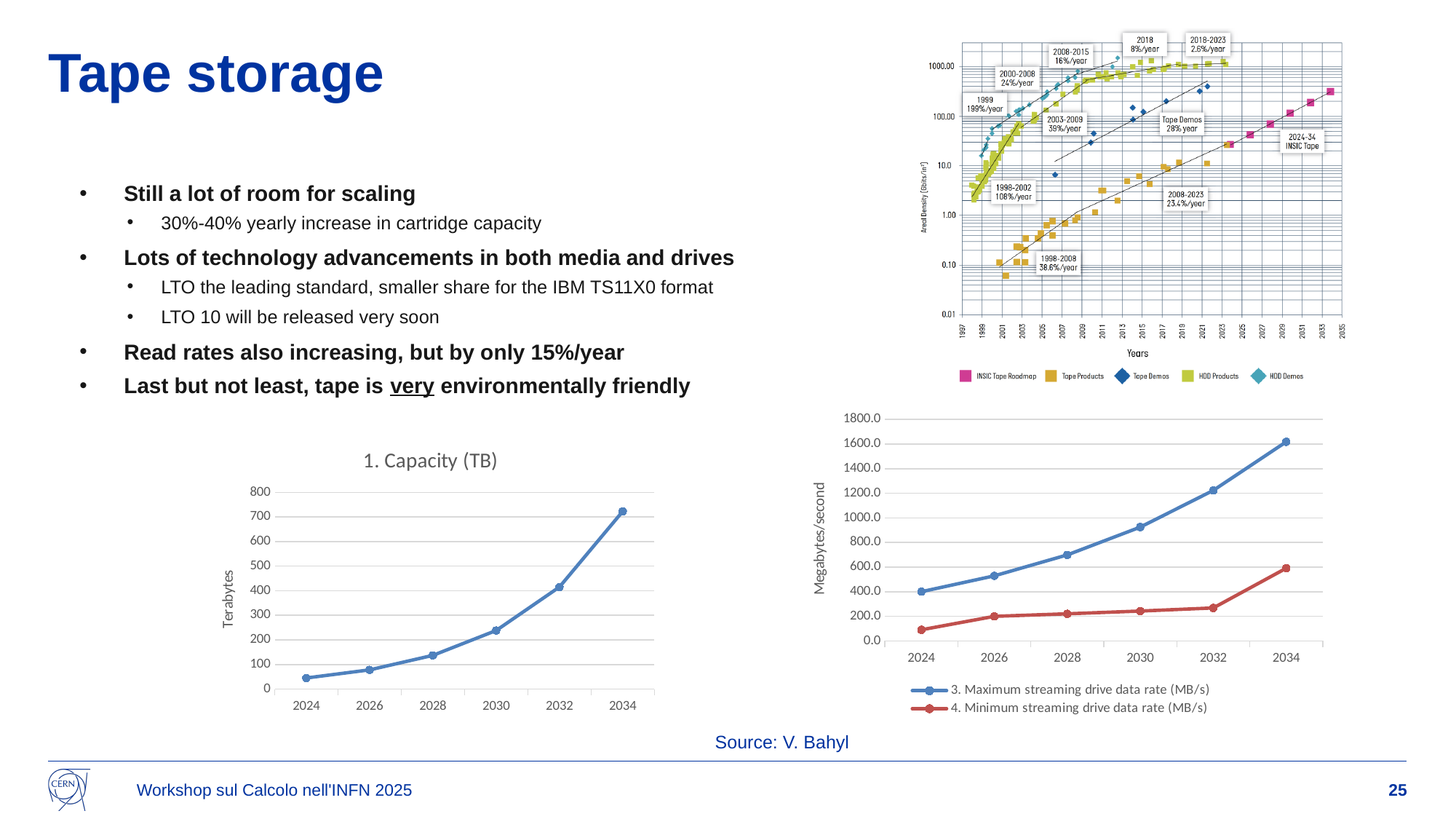
In the '1. Capacity (TB)' chart, which year has the highest capacity? 2034 In the '1. Capacity (TB)' chart, is the value for 2030 greater or less than 200? greater In the '1. Capacity (TB)' chart, do the values rise or fall from 2024 to 2034? rise In the streaming drive data rate chart at the bottom right, how many series does the legend list? 2 In the streaming drive data rate chart at the bottom right, is the value of '4. Minimum streaming drive data rate (MB/s)' for 2024 greater or less than 200.0? less In the '1. Capacity (TB)' chart, is the value for 2024 greater or less than 100? less In the areal density chart at the top right, how many series does the legend list? 5 What kind of chart is the '1. Capacity (TB)' chart at the bottom left of the slide? line chart In the '1. Capacity (TB)' chart, how many years are plotted along the x axis? 6 In the streaming drive data rate chart at the bottom right, which series has the larger value in 2030: the maximum streaming drive data rate or the minimum streaming drive data rate? 3. Maximum streaming drive data rate (MB/s)